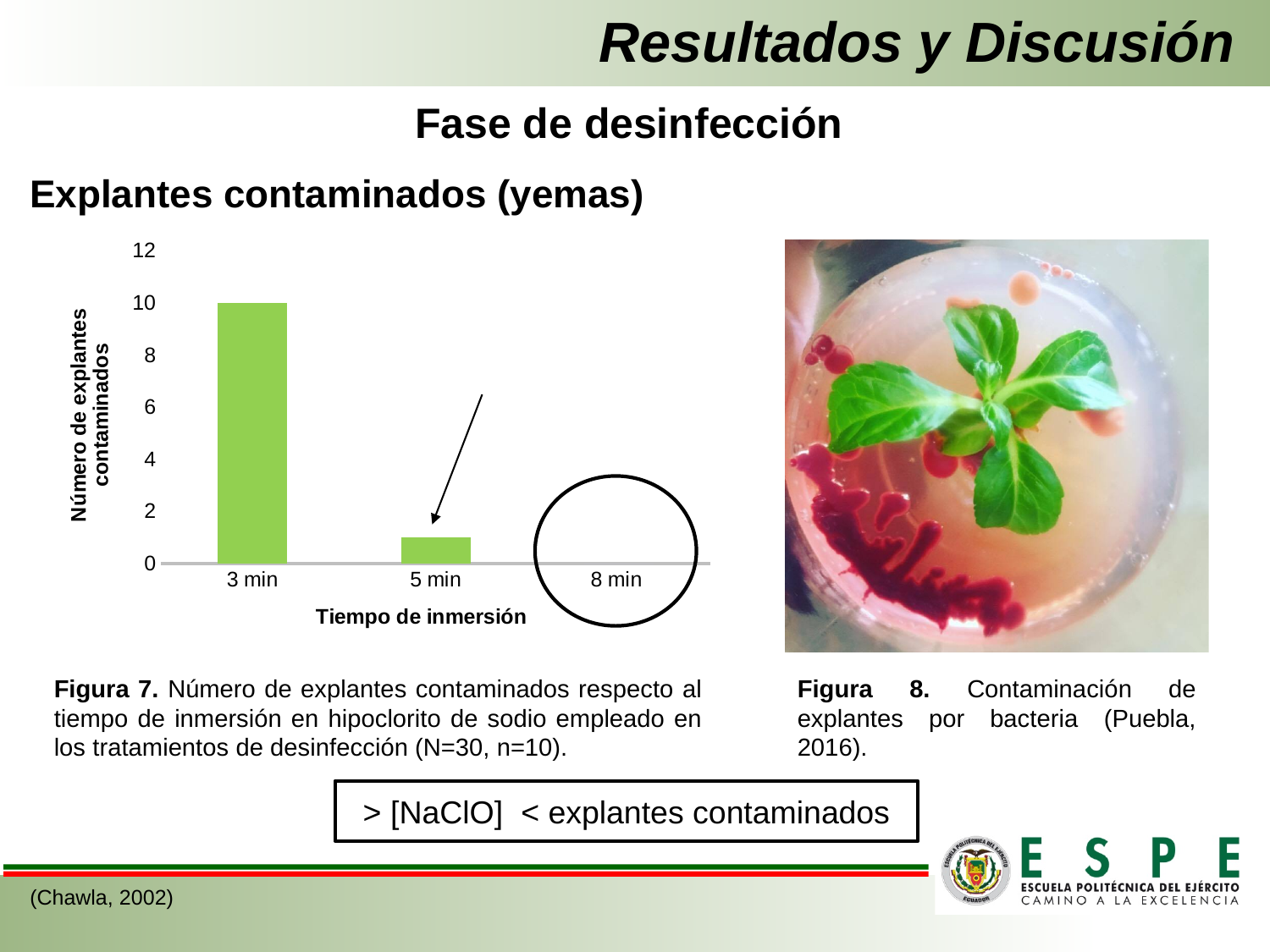
Is the value for 3 min greater or less than 8? greater Do the values rise or fall as the immersion time increases along the x axis? fall Which has more contaminated explants, 3 min or 5 min? 3 min What is the title of the y axis of the chart? Número de explantes contaminados What type of chart is shown in Figura 7? bar chart What is the number of contaminated explants for the 3 min immersion time? 10 How many immersion-time categories are shown on the x axis of the chart? 3 Which immersion time has the highest number of contaminated explants? 3 min Is the value for 5 min greater or less than 2? less Which immersion time has the lowest number of contaminated explants? 8 min What is the title of the x axis of the chart? Tiempo de inmersión